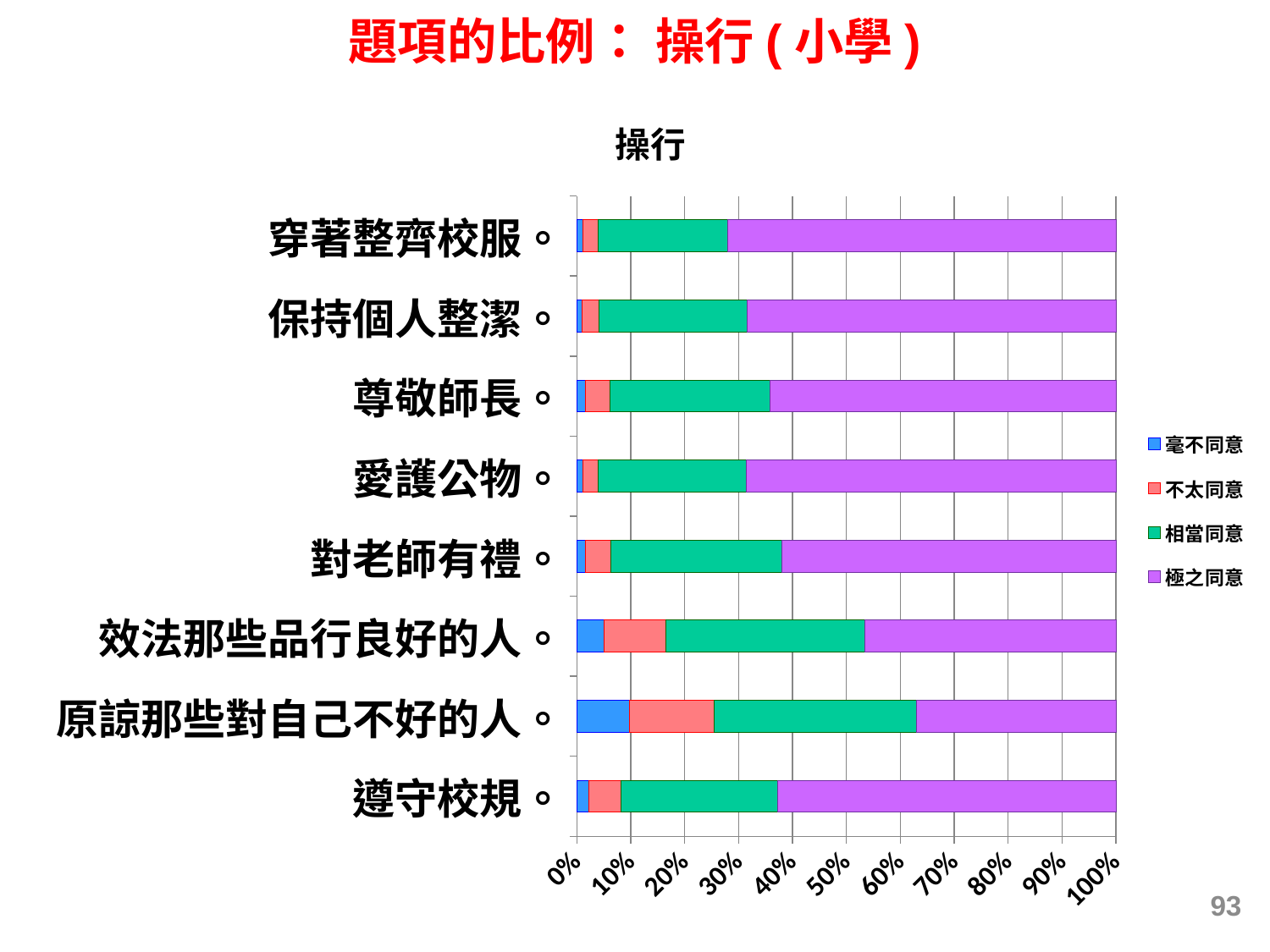
Which legend entry is shown in purple? 極之同意 What is the title of the chart? 操行 Is the 極之同意 value for 穿著整齊校服 greater or less than 60%? greater Which category has the largest 毫不同意 segment? 原諒那些對自己不好的人。 What kind of chart is shown on the slide? Stacked bar chart How many series does the legend list? 4 Is the 毫不同意 segment larger for 原諒那些對自己不好的人 or for 效法那些品行良好的人? 原諒那些對自己不好的人。 Is the 毫不同意 value for 原諒那些對自己不好的人 greater or less than 20%? less Is the 極之同意 value for 原諒那些對自己不好的人 greater or less than 50%? less Which category has the smallest 極之同意 segment? 原諒那些對自己不好的人。 How many categories (items) are plotted on the chart? 8